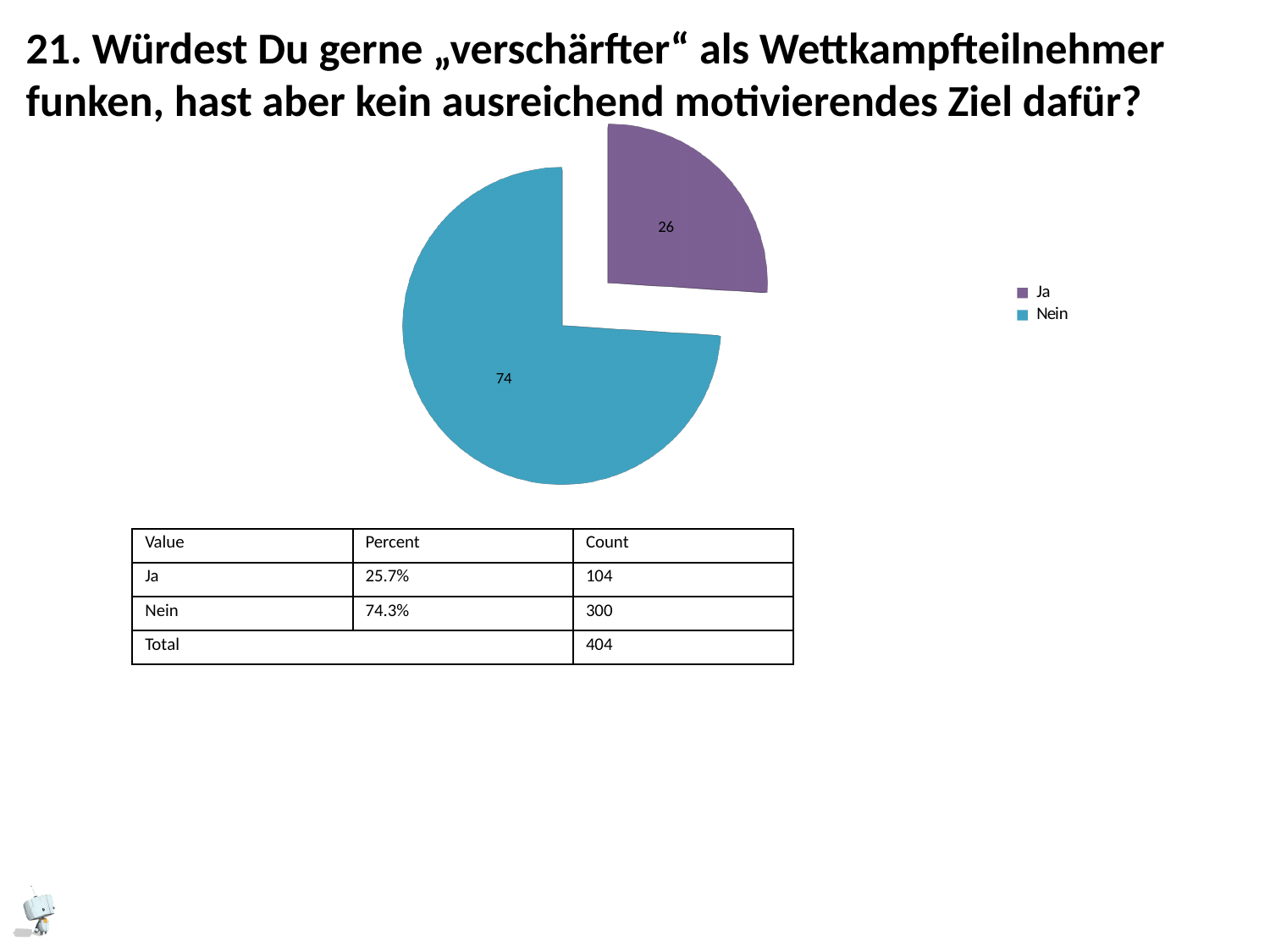
What value is labelled on the "Ja" slice of the pie chart? 26 Which slice has the larger value, "Ja" or "Nein"? Nein What is the difference between the labelled values of the "Nein" and "Ja" slices? 48 How many slices does the pie chart have? 2 How many entries does the legend list? 2 What kind of chart is shown on the slide? pie chart What value is labelled on the "Nein" slice of the pie chart? 74 What colour is the "Ja" slice in the pie chart? purple Which slice of the pie chart is the largest? Nein Which slice of the pie chart is the smallest? Ja Which slice of the pie chart is pulled out from the centre? Ja What is the total of the two labelled values in the pie chart? 100